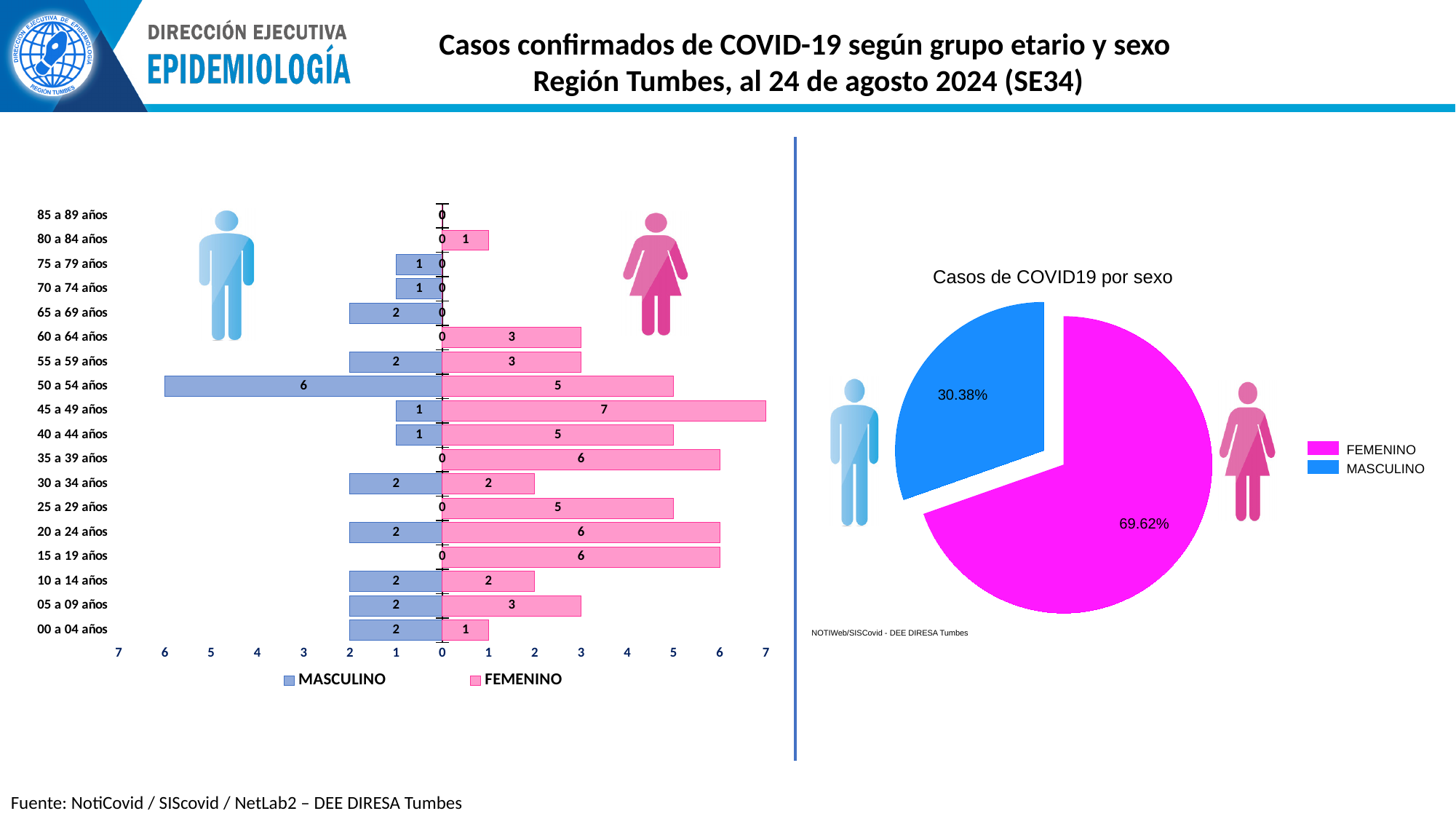
What kind of chart is the chart on the left of the slide? Bar chart In the population pyramid chart on the left, what is the MASCULINO value for the 50 a 54 años age group? 6 In the pie chart titled 'Casos de COVID19 por sexo', what share does MASCULINO have? 30.38% In the population pyramid chart on the left, which age group has the highest MASCULINO value? 50 a 54 años In the population pyramid chart on the left, what is the FEMENINO value for the 45 a 49 años age group? 7 In the population pyramid chart on the left, what is the difference between the FEMENINO and MASCULINO values for the 20 a 24 años age group? 4 In the population pyramid chart on the left, how many age groups are shown? 18 In the population pyramid chart on the left, which is larger for the 50 a 54 años age group, the MASCULINO value or the FEMENINO value? MASCULINO In the population pyramid chart on the left, which age group has the highest FEMENINO value? 45 a 49 años In the pie chart titled 'Casos de COVID19 por sexo', which colour represents FEMENINO? Magenta In the population pyramid chart on the left, how many series does the legend list? 2 In the pie chart titled 'Casos de COVID19 por sexo', what share does FEMENINO have? 69.62%